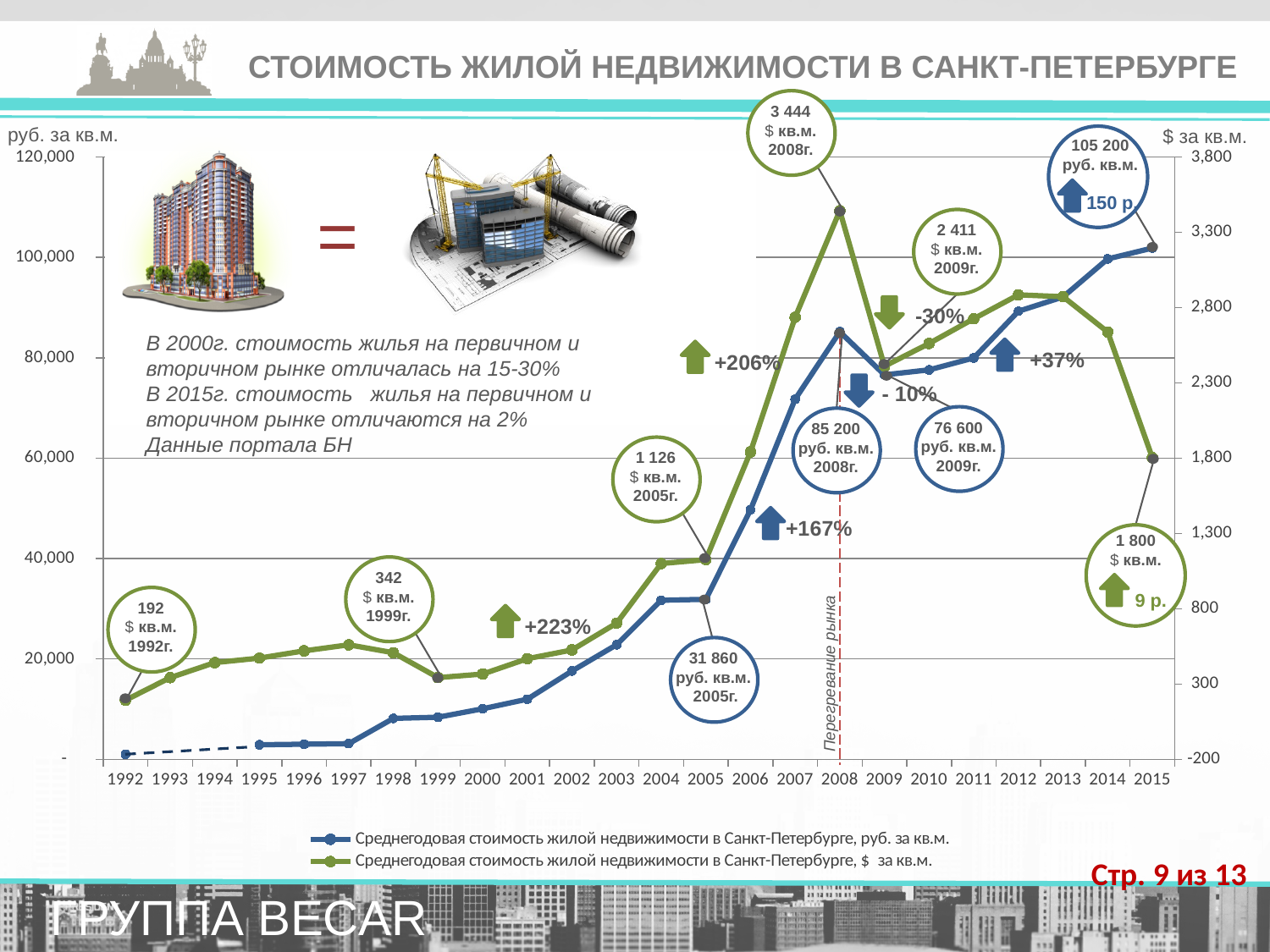
What was the average annual cost in rubles per sq.m. in 2009, according to the callout? 76 600 руб. кв.м. Which is larger: the dollar value per sq.m. in 2008 or in 2009? 2008 What is the difference between the ruble values for 2008 (85 200) and 2009 (76 600)? 8 600 руб. What kind of chart is shown on the slide? line chart Is the ruble value per sq.m. for 2001 greater or less than 20,000? less In which year does the dollar-per-sq.m. series reach its highest point? 2008 What was the average annual cost of residential property in St. Petersburg in dollars per sq.m. in 2008, according to the callout? 3 444 $ кв.м. How many years are plotted on the x axis? 24 Does the dollar-per-sq.m. series rise or fall from 2013 to 2015? fall What ruble value per sq.m. is shown for 2005? 31 860 руб. кв.м. What dollar value per sq.m. is shown for 1992? 192 $ кв.м. How many series does the legend list? 2